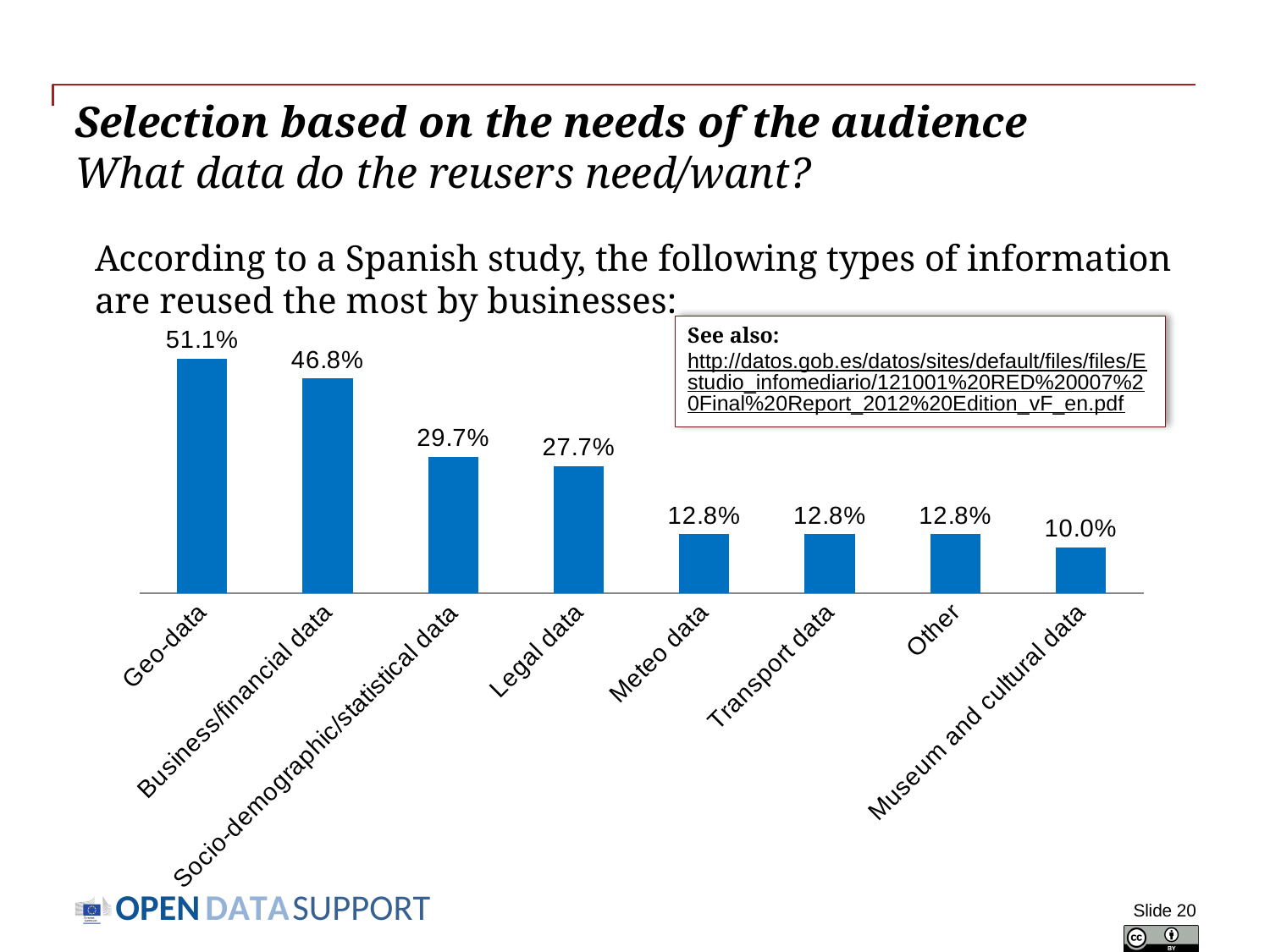
What is the difference between the values for Geo-data and Business/financial data? 4.3% What is the value for Legal data? 27.7% What is the value for Museum and cultural data? 10.0% How many categories are shown in the chart? 8 What is the difference between the values for Socio-demographic/statistical data and Legal data? 2.0% What is the value for Geo-data? 51.1% Which category has the highest value? Geo-data What kind of chart is shown on the slide? Bar chart Which is larger, the value for Socio-demographic/statistical data or the value for Meteo data? Socio-demographic/statistical data What is the value for Business/financial data? 46.8% Which category has the lowest value? Museum and cultural data Do the values rise or fall from left to right along the x axis? Fall